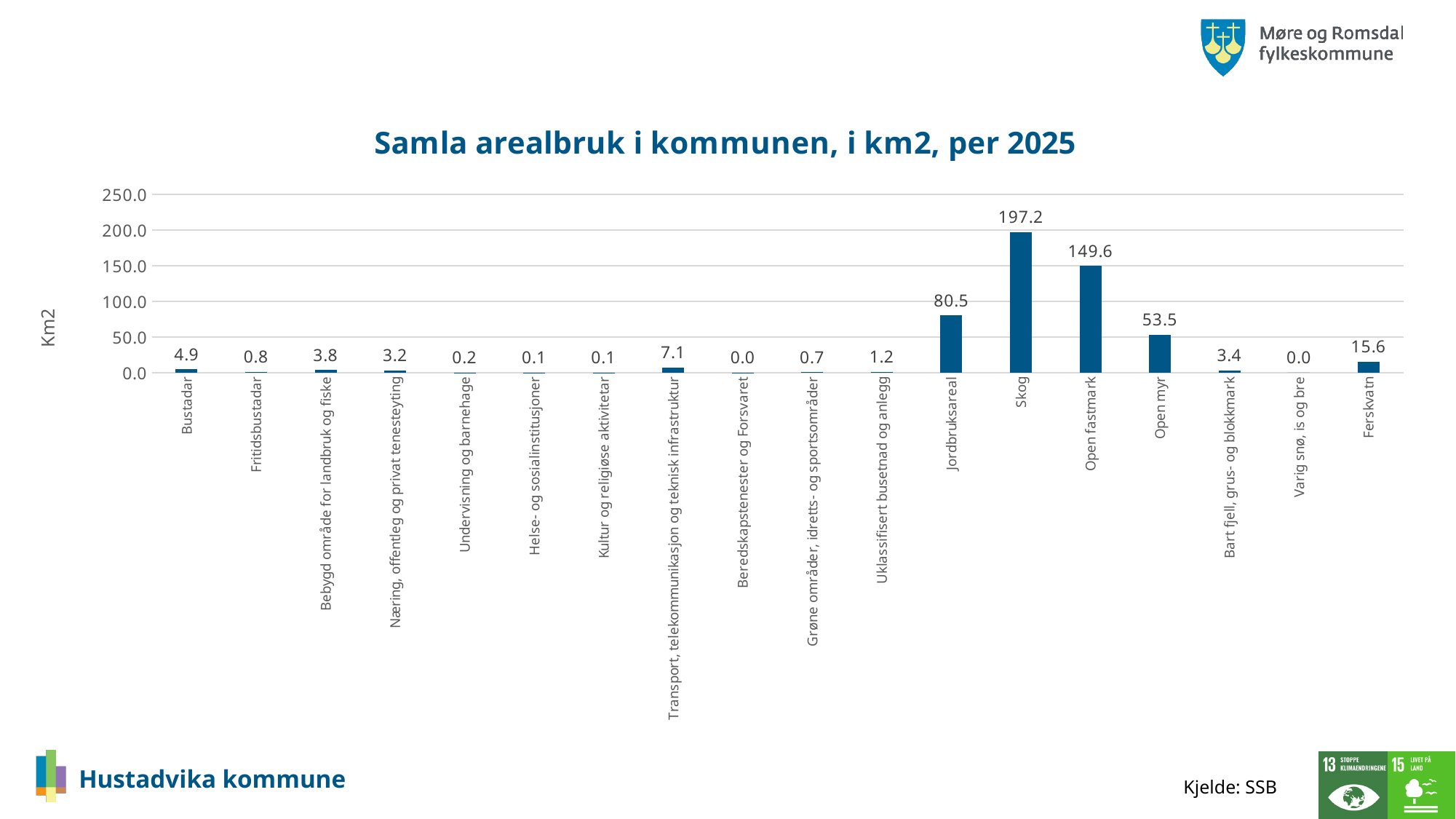
What is the difference between the values for Skog and Open fastmark? 47.6 How many categories are shown on the x axis? 18 What is the title of the chart? Samla arealbruk i kommunen, i km2, per 2025 Which is larger, the value for Bustadar or the value for Transport, telekommunikasjon og teknisk infrastruktur? Transport, telekommunikasjon og teknisk infrastruktur What is the value for Open fastmark? 149.6 What is the value for Jordbruksareal? 80.5 What is the difference between the values for Jordbruksareal and Open myr? 27.0 Which category has the highest value? Skog Is the value for Open myr greater or less than 100.0? less What kind of chart is shown on the slide? bar chart What is the value for Skog? 197.2 What is the value for Ferskvatn? 15.6